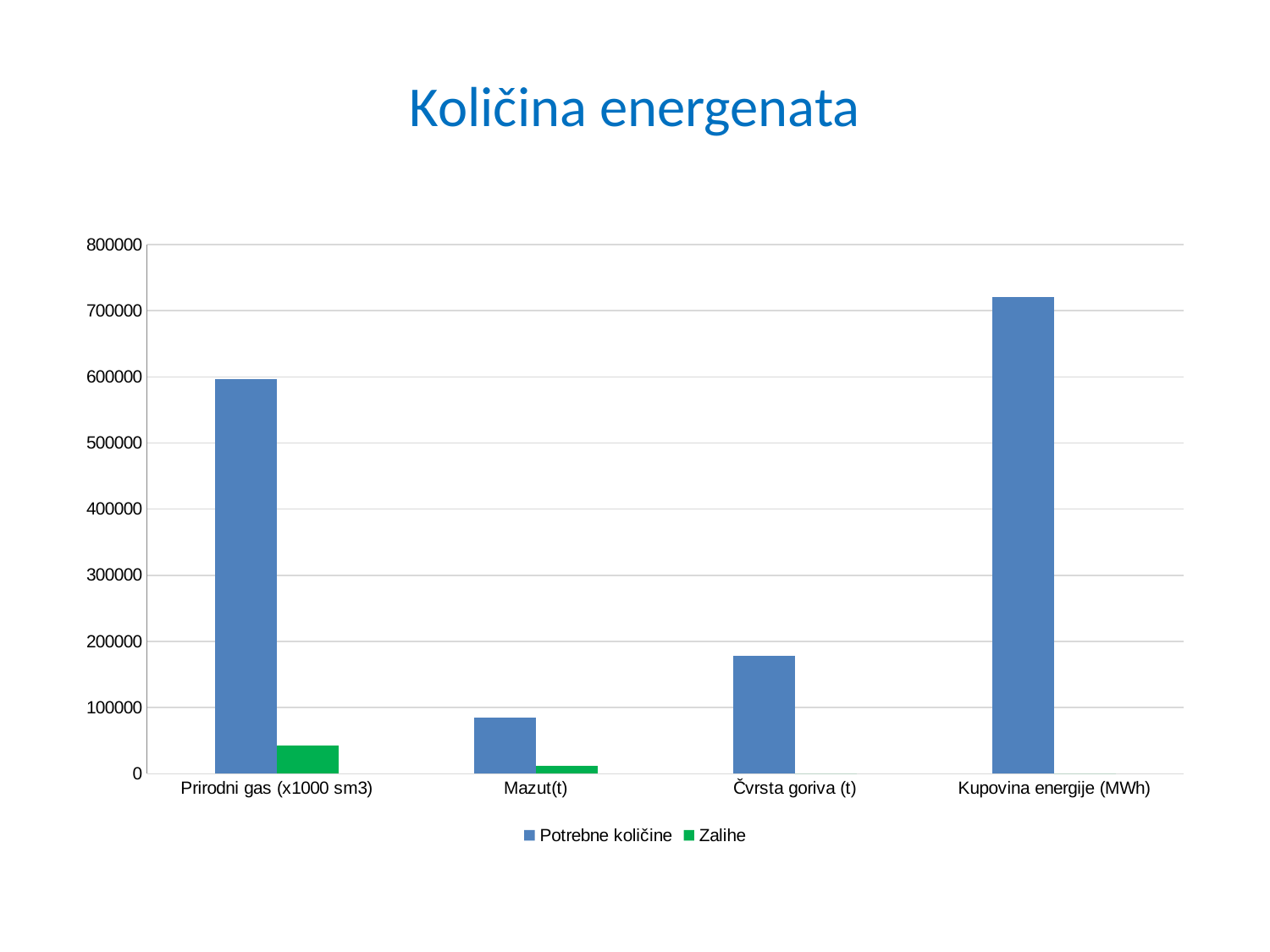
Is the Potrebne količine value for Mazut(t) greater or less than 100000? less Is the Potrebne količine value for Kupovina energije (MWh) greater or less than 700000? greater How many series does the legend list? 2 Which is larger, the Zalihe value for Prirodni gas (x1000 sm3) or the Zalihe value for Mazut(t)? Prirodni gas (x1000 sm3) What kind of chart is shown on the slide? bar chart Which category has the highest value for Potrebne količine? Kupovina energije (MWh) How many categories are shown on the x axis? 4 Which colour represents the Zalihe series in the legend? green What is the title of the chart? Količina energenata Which category has the lowest value for Potrebne količine? Mazut(t) Is the Potrebne količine value for Prirodni gas (x1000 sm3) greater or less than 500000? greater